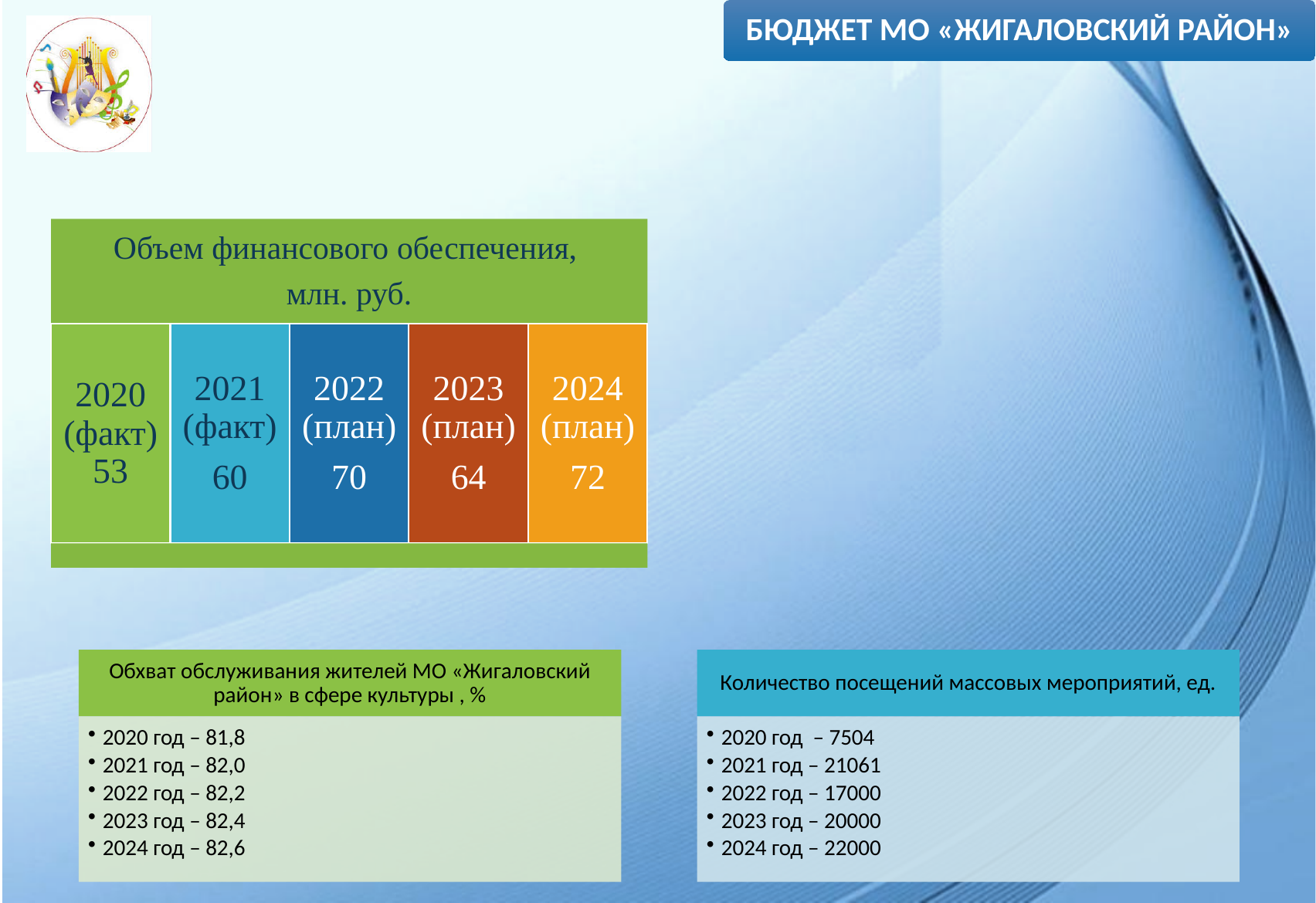
In the chart 'Объем финансового обеспечения, млн. руб.', how many years are marked as 'план'? 3 In the chart 'Объем финансового обеспечения, млн. руб.', what is the difference between the values for 2022 (план) and 2023 (план)? 6 In the chart 'Объем финансового обеспечения, млн. руб.', what is the value for 2020 (факт)? 53 What unit is given in the title of the chart 'Объем финансового обеспечения'? млн. руб. In the chart 'Объем финансового обеспечения, млн. руб.', which year has the highest value? 2024 (план) In the chart 'Объем финансового обеспечения, млн. руб.', what is the difference between the values for 2024 (план) and 2020 (факт)? 19 In the chart 'Объем финансового обеспечения, млн. руб.', which is larger: the value for 2021 (факт) or 2023 (план)? 2023 (план) In the chart 'Объем финансового обеспечения, млн. руб.', what is the value for 2023 (план)? 64 How many years are shown in the chart 'Объем финансового обеспечения, млн. руб.'? 5 In the chart 'Объем финансового обеспечения, млн. руб.', what is the value for 2022 (план)? 70 In the chart 'Объем финансового обеспечения, млн. руб.', which year has the lowest value? 2020 (факт) In the chart 'Объем финансового обеспечения, млн. руб.', what is the value for 2024 (план)? 72